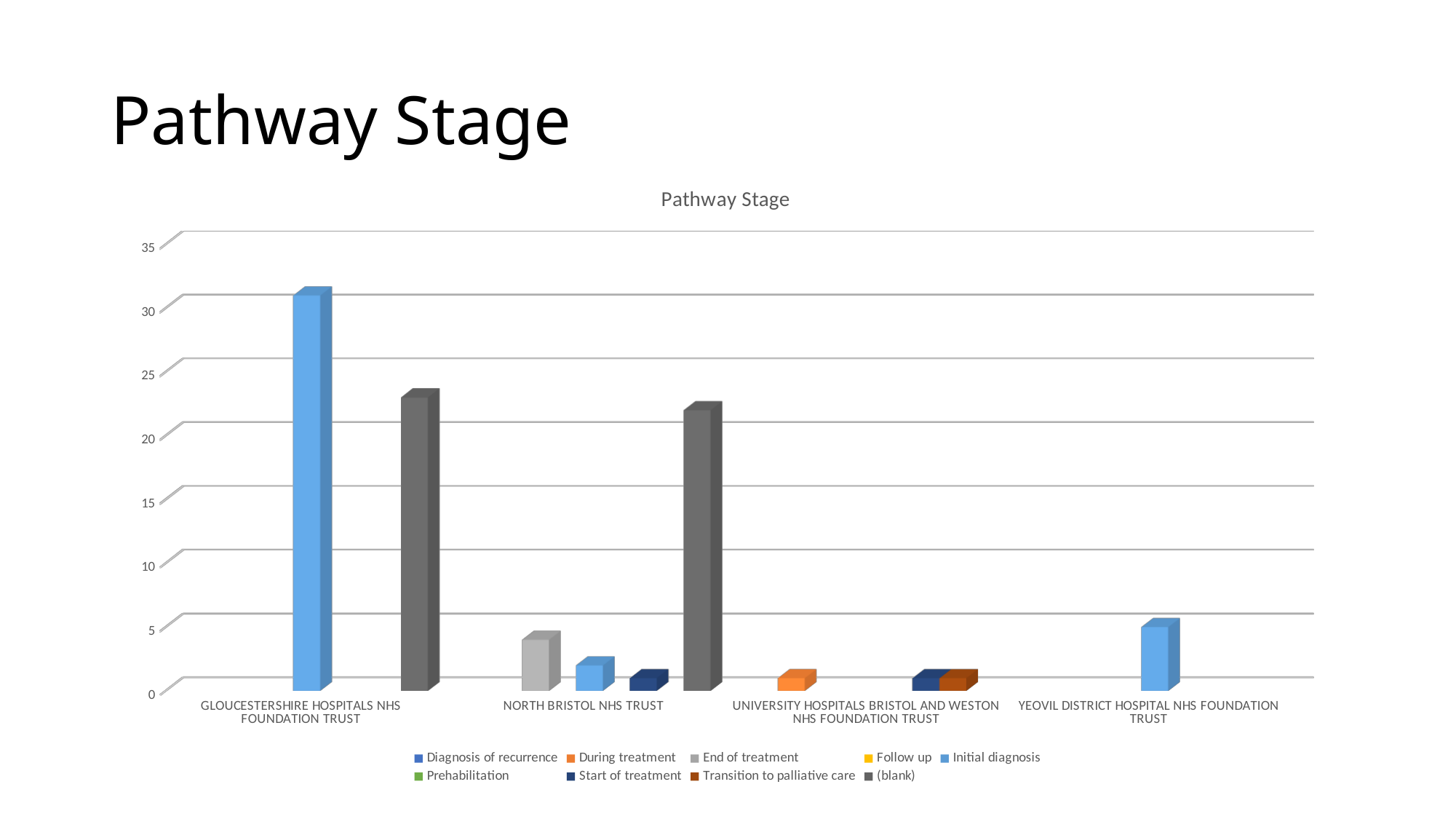
What kind of chart is shown on the slide? bar chart For Gloucestershire Hospitals NHS Foundation Trust, which is larger: the Initial diagnosis value or the (blank) value? Initial diagnosis Is the End of treatment value for North Bristol NHS Trust greater or less than 5? less Is the (blank) value for North Bristol NHS Trust greater or less than 20? greater Is the (blank) value for Gloucestershire Hospitals NHS Foundation Trust greater or less than 25? less How many series does the legend list? 9 Which series has the tallest bar for Gloucestershire Hospitals NHS Foundation Trust? Initial diagnosis Which trust has the tallest bar in the chart? Gloucestershire Hospitals NHS Foundation Trust How many trusts (categories) are shown on the x axis? 4 What is the title of the chart? Pathway Stage